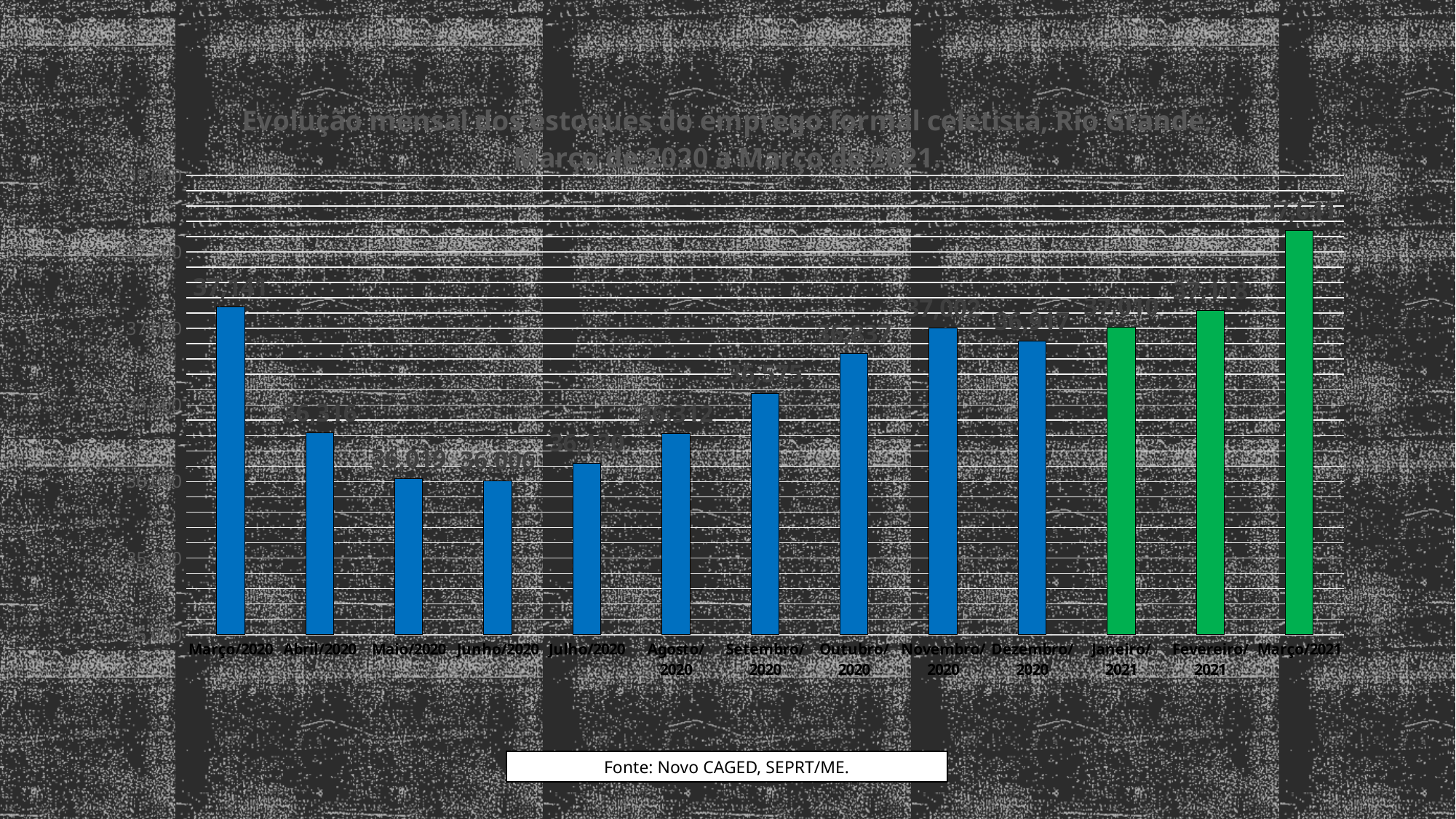
Do the values rise or fall from Junho/2020 to Novembro/2020? rise What kind of chart is shown on the slide? Bar chart What is the value for Março/2020? 37,141 Is the value for Setembro/2020 greater or less than 37,000? less What is the difference between the values for Março/2020 and Junho/2020? 1,135 What is the value for Junho/2020? 36,006 Is the value for Março/2021 greater or less than 37,500? greater What is the value for Maio/2020? 36,019 How many months (categories) are plotted on the x axis? 13 Which month has the highest value? Março/2021 Which is larger, the value for Março/2020 or the value for Dezembro/2020? Março/2020 What is the value for Agosto/2020? 36,312